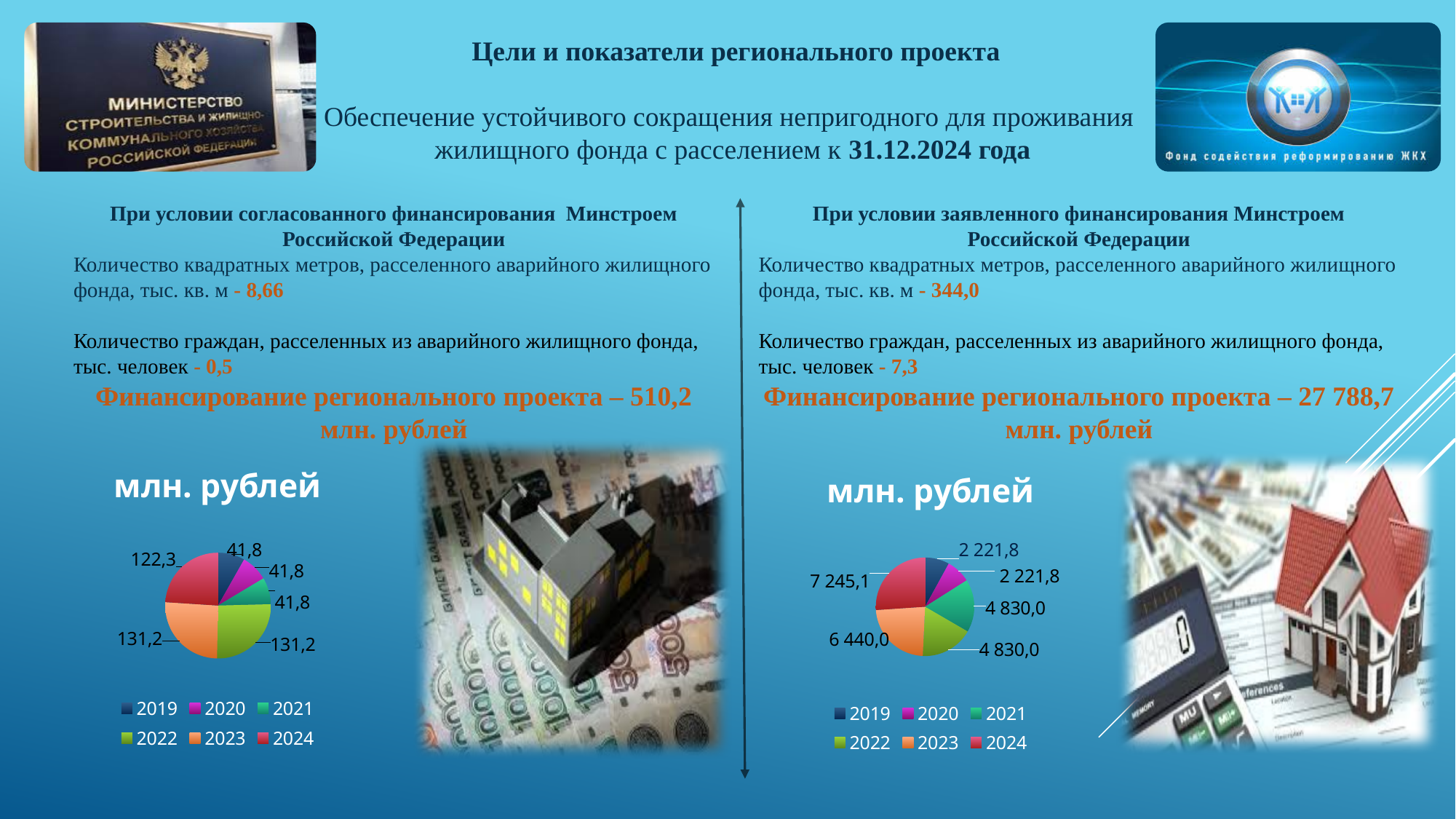
In the left pie chart, what is the difference between the values for 2022 and 2021? 89,4 In the left pie chart, what is the value for 2019? 41,8 In the left pie chart, which is larger, the value for 2024 or the value for 2020? 2024 What is the total of all slices in the right pie chart? 27 788,7 In the right pie chart, what is the value for 2024? 7 245,1 In the right pie chart, which year has the highest value? 2024 In the left pie chart, what is the value for 2024? 122,3 How many series does the legend of the left pie chart list? 6 In the left pie chart, what is the value for 2023? 131,2 In the right pie chart, what is the difference between the values for 2024 and 2023? 805,1 What kind of chart is the left chart on the slide? pie chart In the right pie chart, what is the value for 2023? 6 440,0